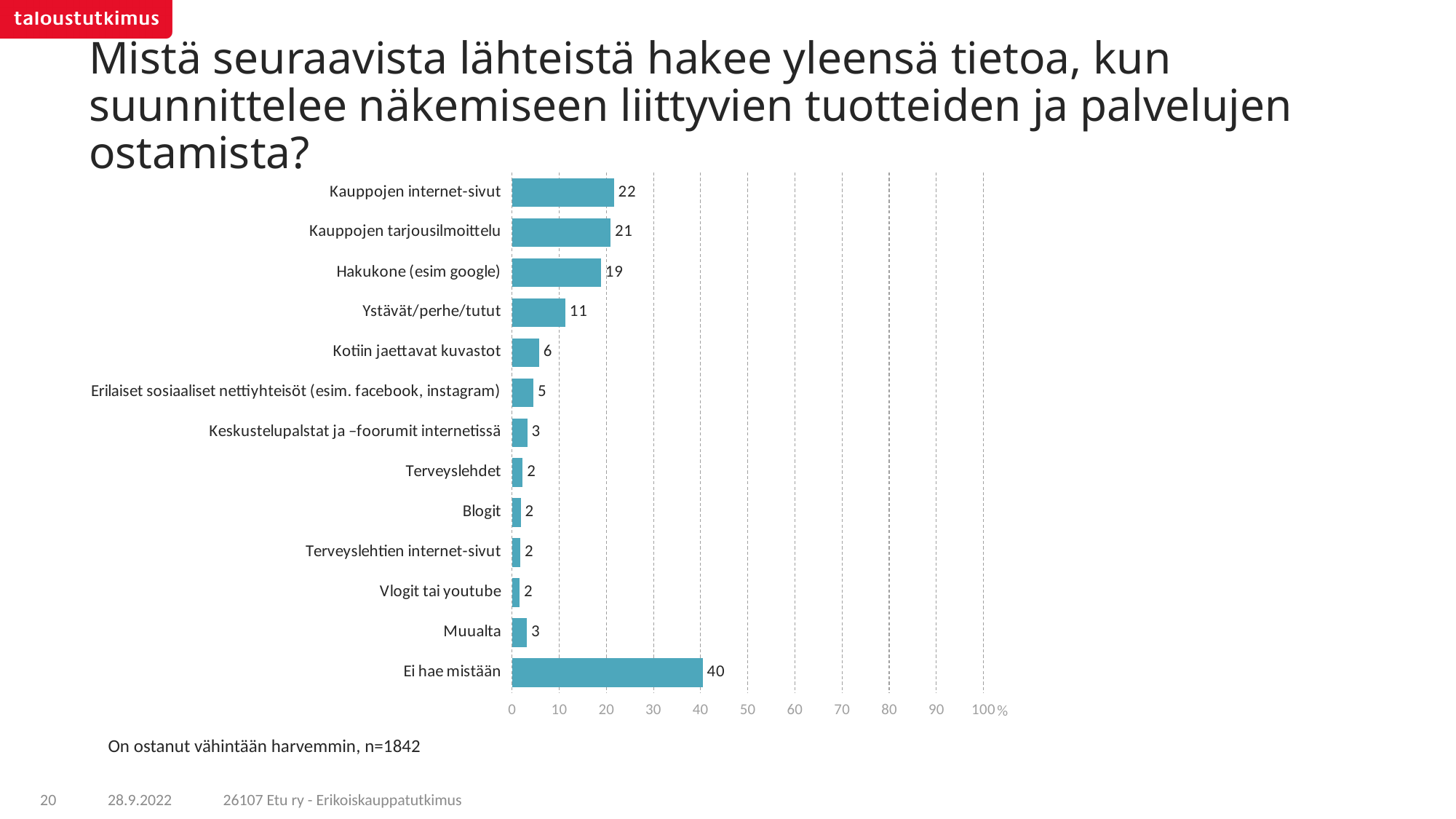
What is the sample size stated below the chart? n=1842 What is the difference between the values for Ei hae mistään and Kauppojen internet-sivut? 18 Which is larger, the value for Kauppojen tarjousilmoittelu or the value for Hakukone (esim google)? Kauppojen tarjousilmoittelu How many categories are shown in the chart? 13 What is the difference between the values for Hakukone (esim google) and Ystävät/perhe/tutut? 8 What is the value for Ei hae mistään? 40 Which category has the highest value? Ei hae mistään What is the value for Ystävät/perhe/tutut? 11 What is the value for Kauppojen internet-sivut? 22 What is the value for Kotiin jaettavat kuvastot? 6 What kind of chart is shown on the slide? bar chart Is the value for Ei hae mistään greater or less than 30? greater